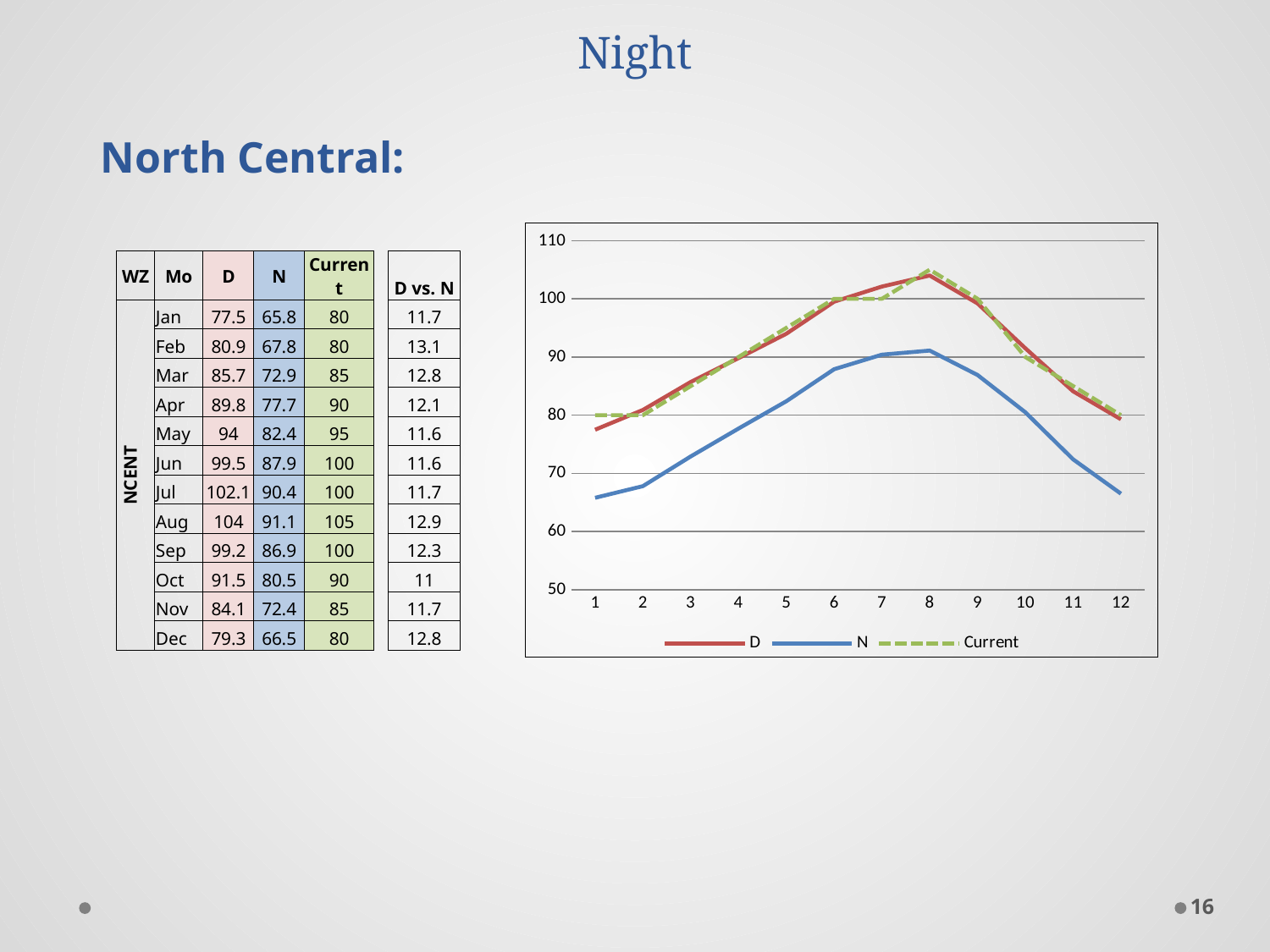
At point 6, which series has the larger value, D or N? D According to the table on the slide, what is the D value for Aug? 104 Which series in the chart is drawn with a dashed line? Current How many series does the chart legend list? 3 Is the value of the Current series at point 8 greater or less than 100? greater How many points are plotted along the x axis of the chart? 12 According to the table on the slide, what is the difference between D and N for Aug (D vs. N)? 12.9 Is the value of the D series at point 8 greater or less than 100? greater Is the value of the N series at point 1 greater or less than 70? less At which x-axis point does the N series reach its highest value? 8 Does the D series rise or fall from point 1 to point 8? rise What type of chart is shown on the slide? line chart